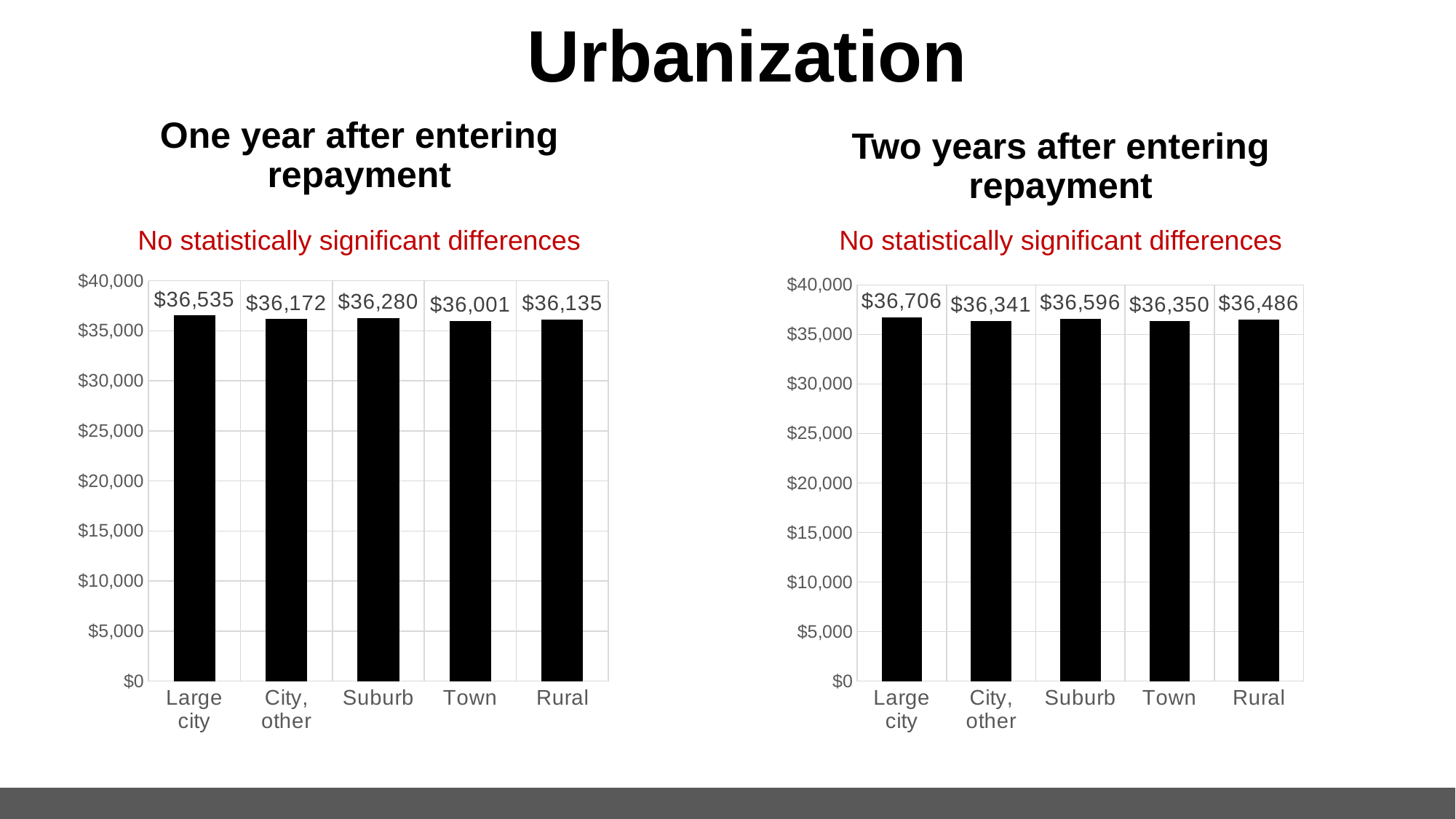
In the 'Two years after entering repayment' chart, which is larger, the value for Suburb or the value for Town? Suburb In the 'One year after entering repayment' chart, what is the value for Large city? $36,535 In the 'One year after entering repayment' chart, which category has the highest value? Large city What kind of chart is the 'Two years after entering repayment' chart? Bar chart In the 'One year after entering repayment' chart, what is the difference between the Large city value and the Town value? $534 In the 'One year after entering repayment' chart, what is the value for Town? $36,001 How many categories are shown in the 'One year after entering repayment' chart? 5 In the 'Two years after entering repayment' chart, what is the value for Rural? $36,486 In the 'Two years after entering repayment' chart, what is the value for Suburb? $36,596 In the 'Two years after entering repayment' chart, which category has the lowest value? City, other What does the red text above each chart say? No statistically significant differences In the 'Two years after entering repayment' chart, what is the difference between the Large city value and the City, other value? $365